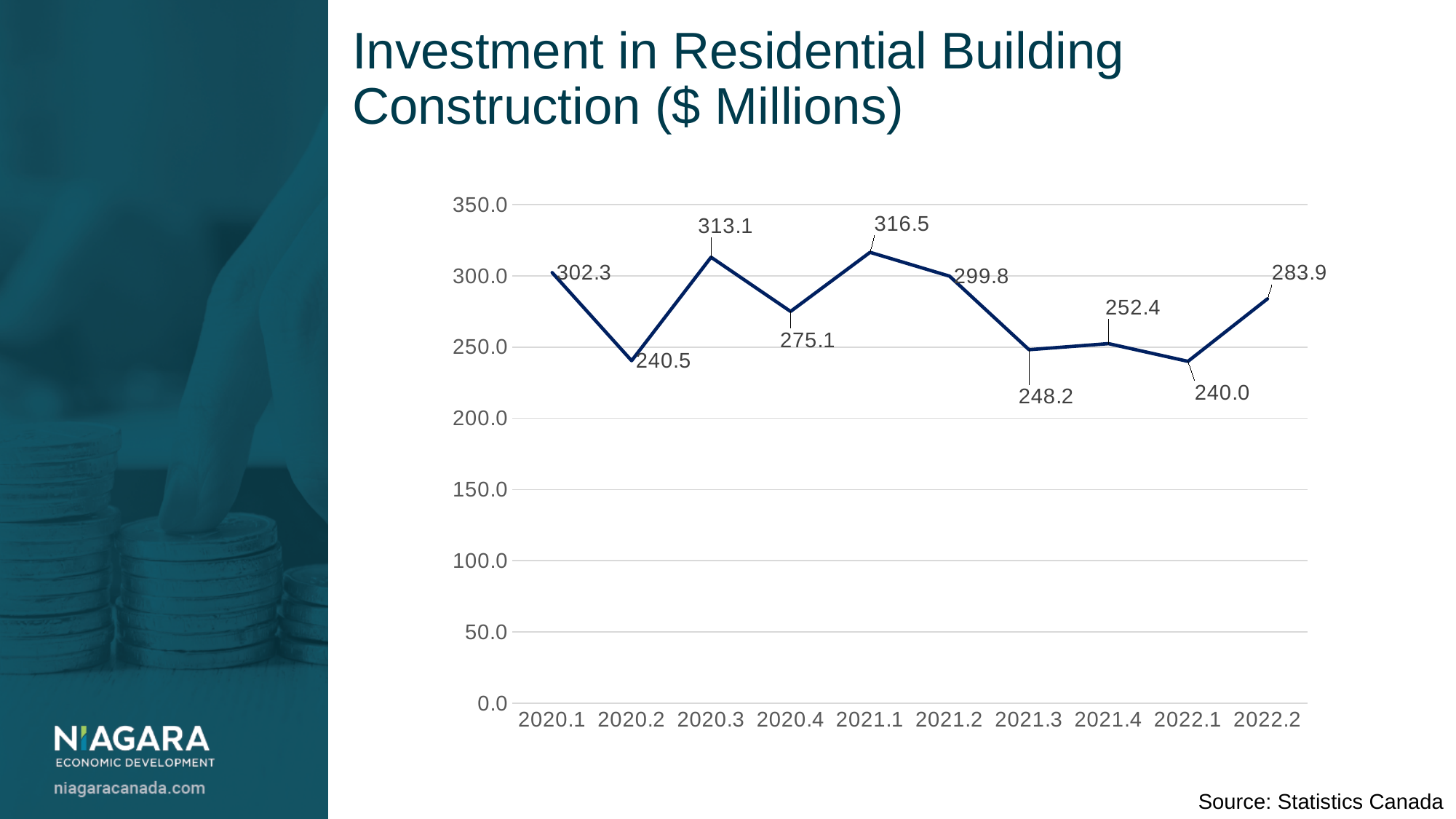
What is the difference between the values for 2020.3 and 2020.4? 38.0 Is the value for 2021.2 greater or less than 250.0? greater Which is larger, the value for 2021.4 or the value for 2022.1? 2021.4 What is the value for 2021.1? 316.5 Which period has the lowest value? 2022.1 What is the value for 2020.1? 302.3 What is the title of the chart? Investment in Residential Building Construction ($ Millions) How many periods are plotted on the x axis? 10 What kind of chart is shown? line chart What is the value for 2022.2? 283.9 Do the values rise or fall from 2021.1 to 2021.3? fall Which period has the highest value? 2021.1